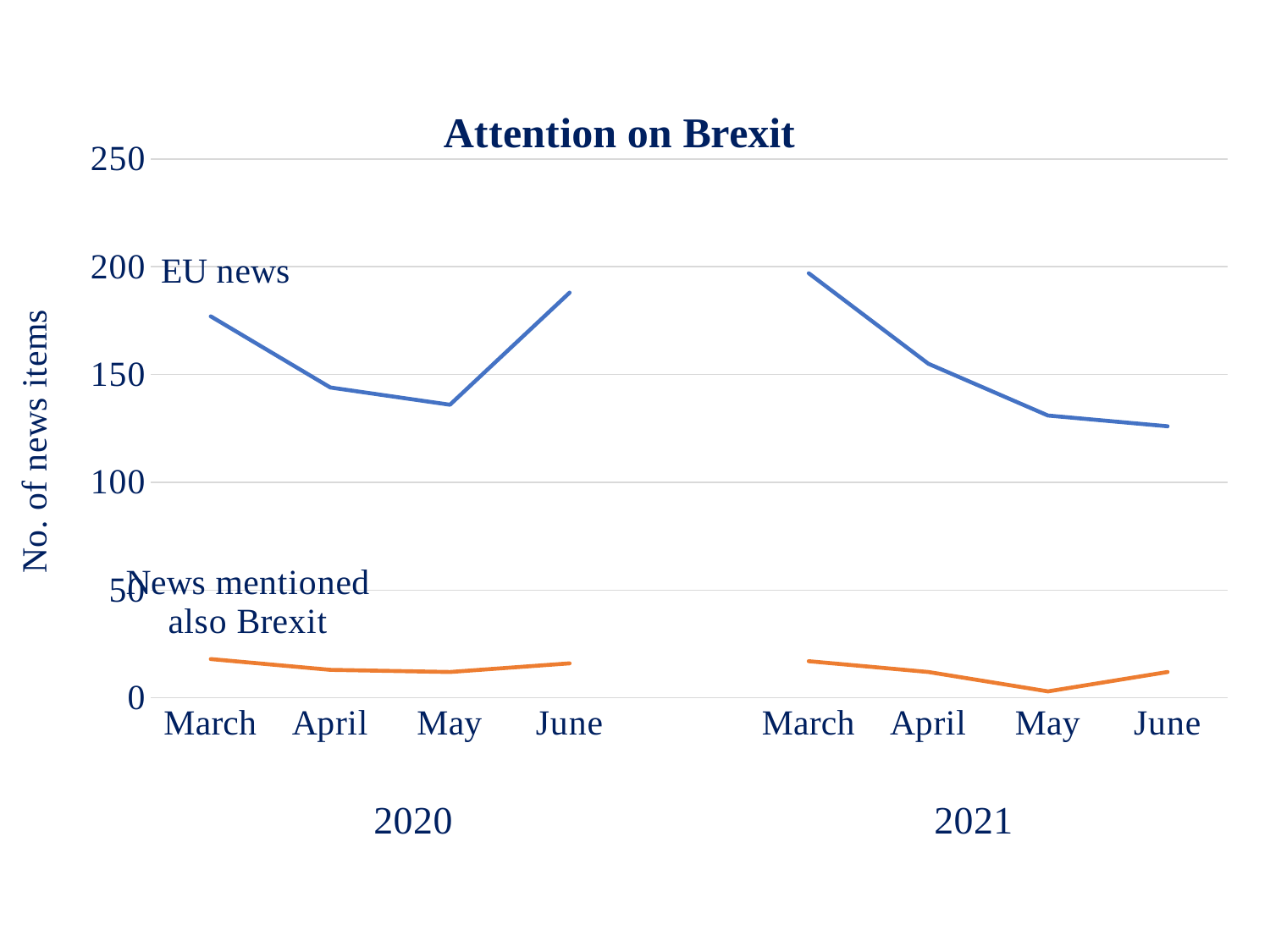
Is the value for EU news in March 2021 greater or less than 150? greater In which month is the News mentioned also Brexit line at its lowest? May 2021 What is the title of the chart? Attention on Brexit What kind of chart is shown on the slide? line chart Does the EU news line rise or fall from March to June 2021? fall Which is larger, the EU news value for March 2020 or for April 2020? March 2020 What is the label on the vertical axis of the chart? No. of news items How many data series are plotted in the chart? 2 Is the value for EU news in June 2021 greater or less than 150? less Is the value for News mentioned also Brexit in March 2020 greater or less than 50? less How many months are shown on the x axis for each year? 4